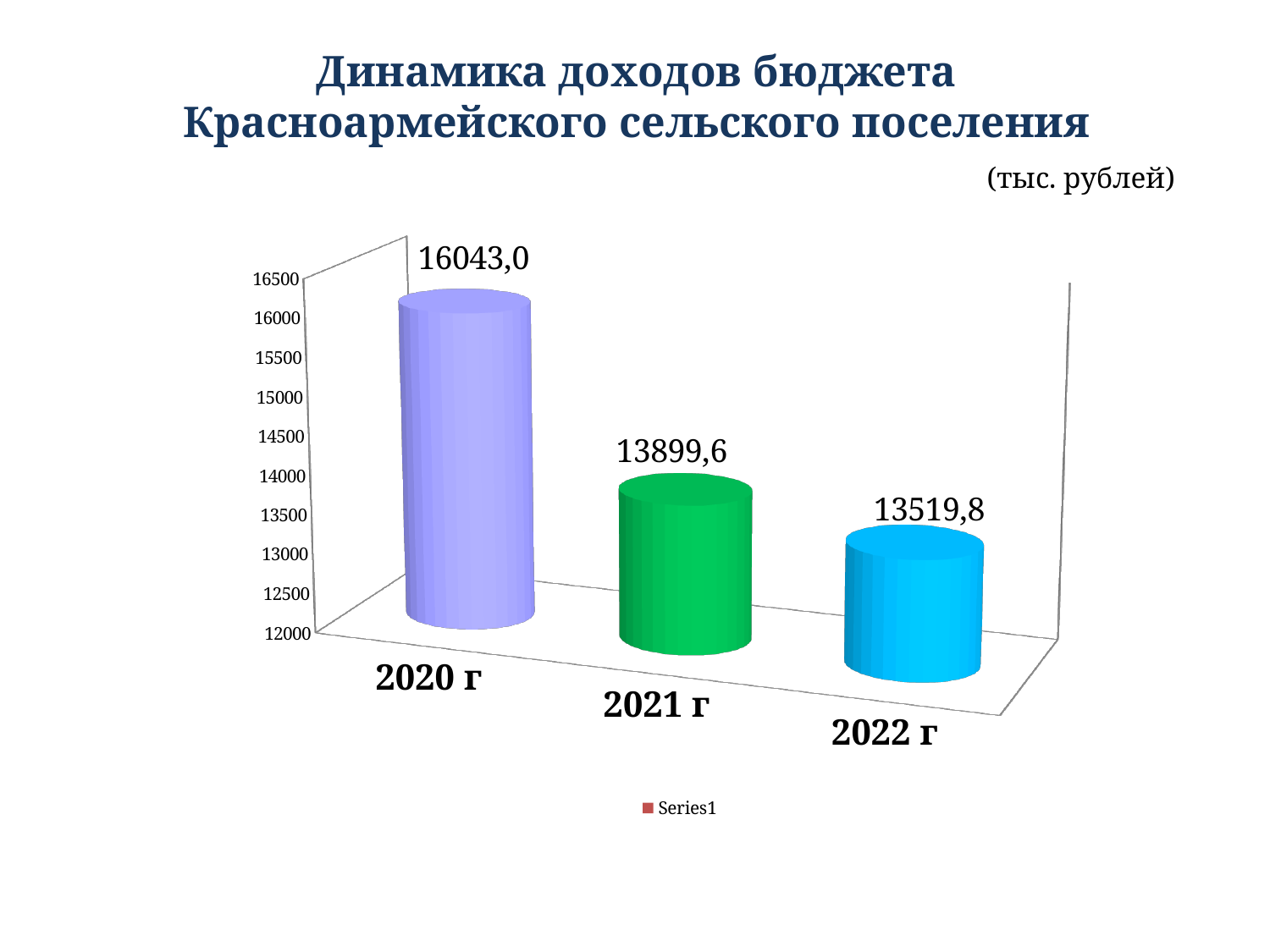
What kind of chart is shown on the slide? bar chart Which year has the lowest value? 2022 г What is the difference between the values for 2020 г and 2021 г? 2143,4 How many series does the legend list? 1 What is the difference between the values for 2021 г and 2022 г? 379,8 Which year has the highest value? 2020 г Do the values rise or fall from 2020 г to 2022 г? fall What is the value for 2021 г? 13899,6 Which is larger, the value for 2021 г or the value for 2022 г? 2021 г What is the value for 2020 г? 16043,0 What is the value for 2022 г? 13519,8 How many years are shown on the chart? 3